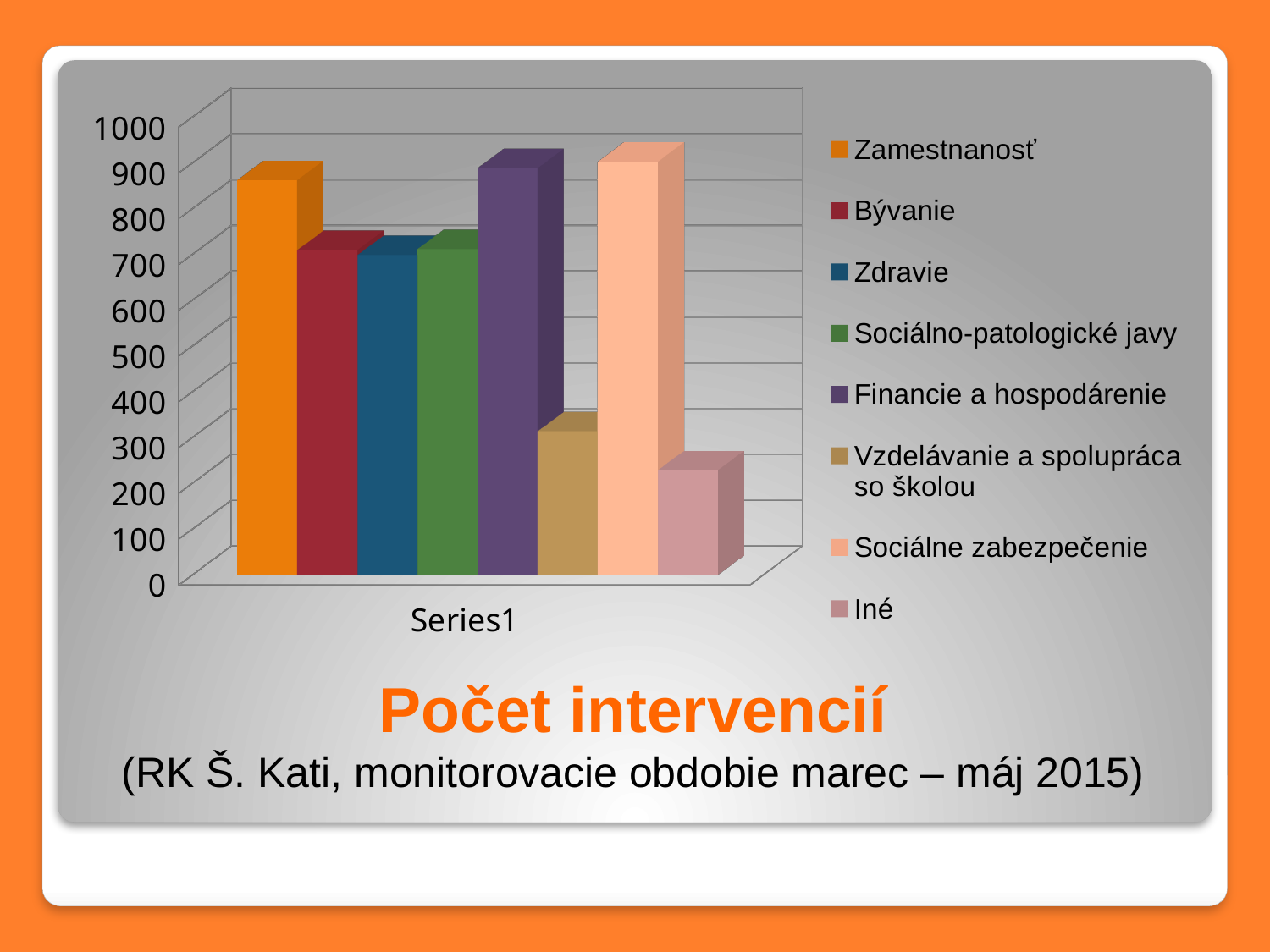
Is the value for Financie a hospodárenie greater or less than 600? greater Is the value for Zamestnanosť greater or less than 500? greater How many entries does the legend list? 8 Which is larger, the value for Zamestnanosť or the value for Iné? Zamestnanosť Which is larger, the value for Vzdelávanie a spolupráca so školou or the value for Sociálne zabezpečenie? Sociálne zabezpečenie Which legend entry has the lowest bar? Iné Is the value for Iné greater or less than 500? less How many bars are plotted in the chart? 8 What is the title shown below the chart? Počet intervencií What kind of chart is shown on the slide? bar chart